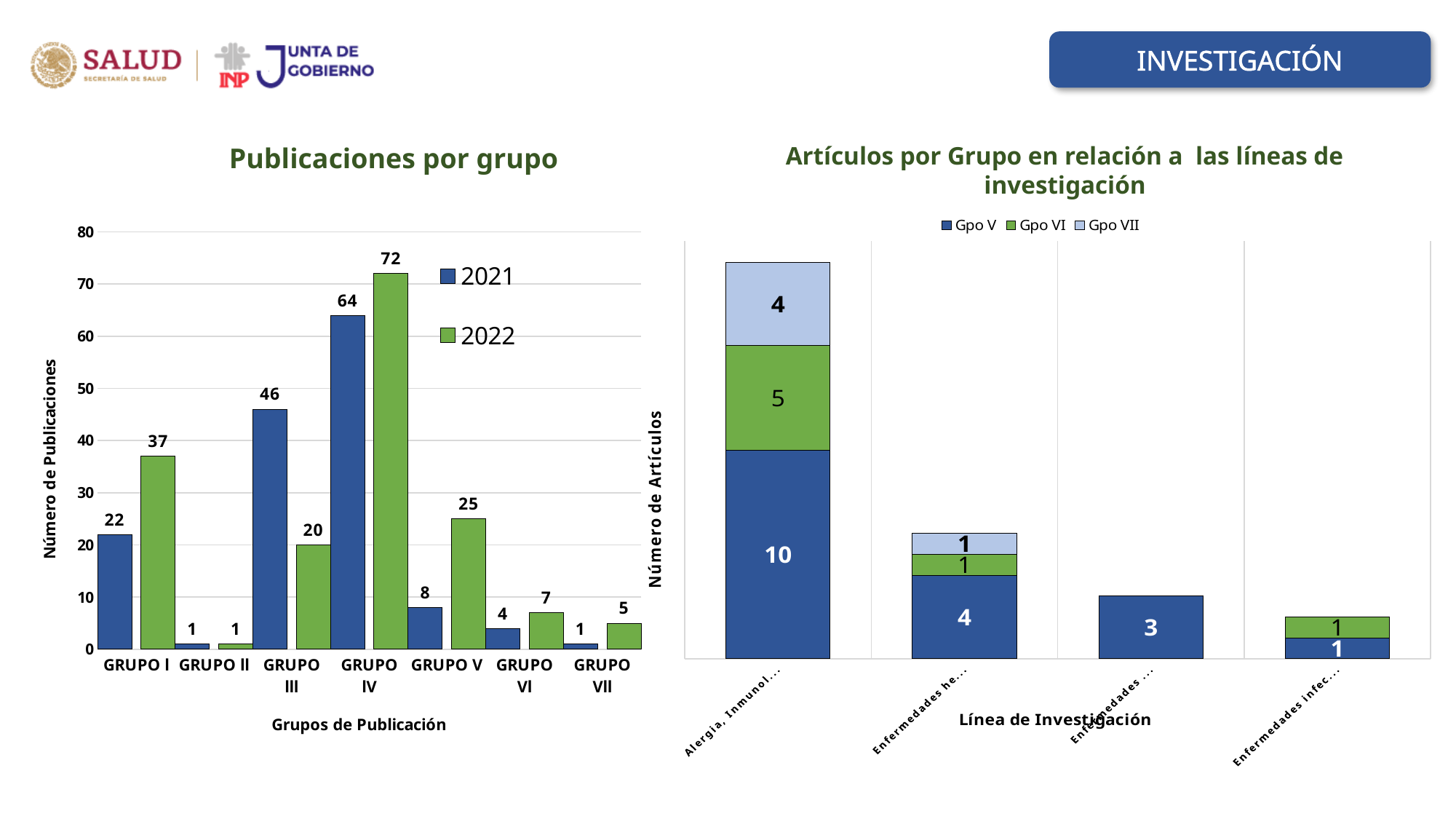
In the 'Publicaciones por grupo' chart, how many groups are shown on the x axis? 7 In the 'Artículos por Grupo en relación a las líneas de investigación' chart, how many series does the legend list? 3 In the 'Artículos por Grupo en relación a las líneas de investigación' chart, what is the Gpo V value for the first (leftmost) bar? 10 In the 'Publicaciones por grupo' chart, which group had the highest number of publications in 2021? GRUPO IV What type of chart is 'Publicaciones por grupo'? Bar chart In the 'Artículos por Grupo en relación a las líneas de investigación' chart, what is the total of the first (leftmost) stacked bar? 19 In the 'Publicaciones por grupo' chart, what is the difference between the 2022 and 2021 values for GRUPO I? 15 In the 'Publicaciones por grupo' chart, how many series does the legend list? 2 In the 'Artículos por Grupo en relación a las líneas de investigación' chart, what is the Gpo V value for the third bar from the left? 3 In the 'Publicaciones por grupo' chart, how many publications did GRUPO III have in 2021? 46 In the 'Publicaciones por grupo' chart, how many publications did GRUPO IV have in 2022? 72 In the 'Publicaciones por grupo' chart, which is larger for GRUPO III: the 2021 value or the 2022 value? 2021